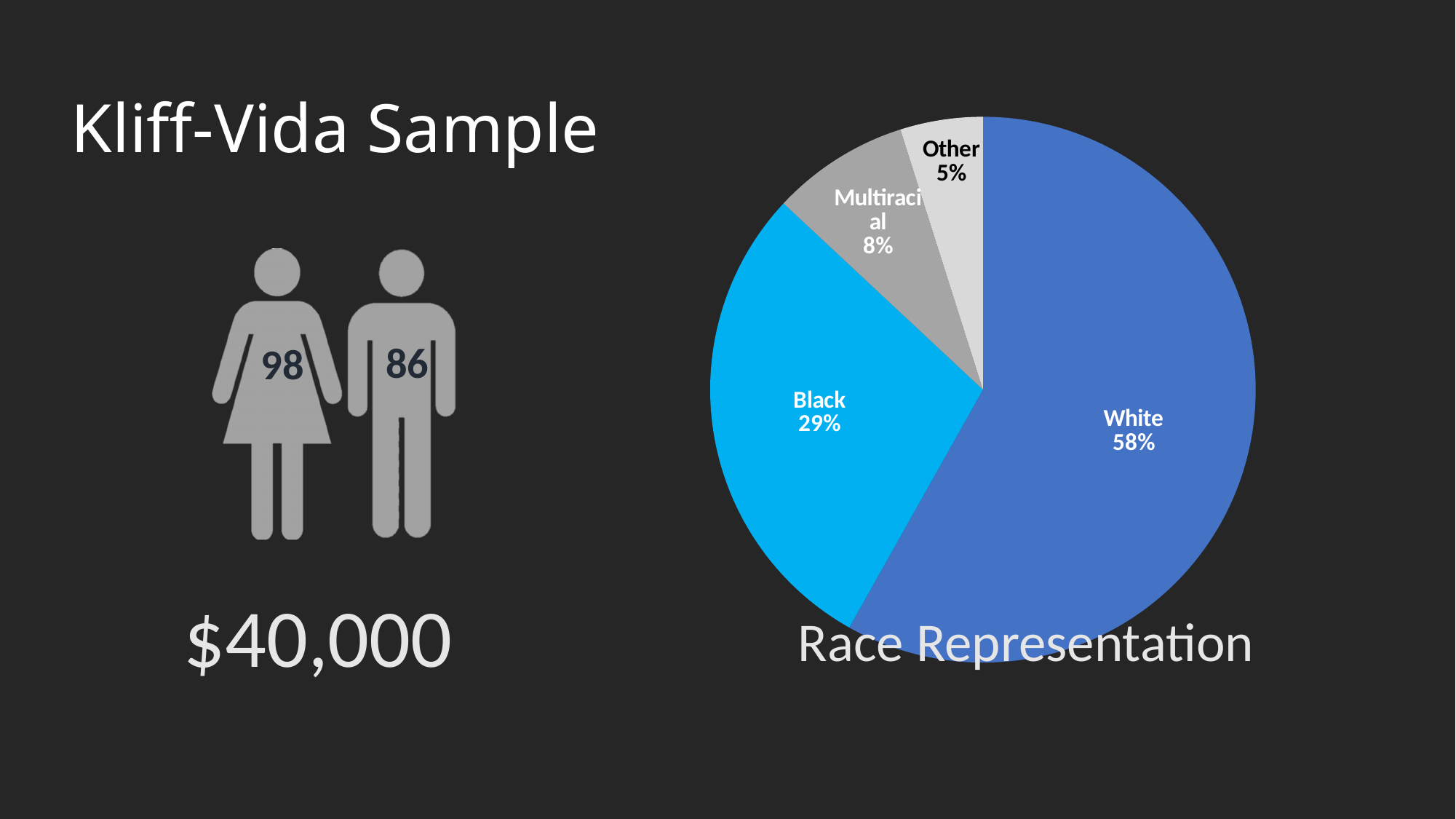
What share of the Race Representation pie chart is Other? 5% What share of the Race Representation pie chart is Multiracial? 8% In the Race Representation pie chart, which is larger, Multiracial or Other? Multiracial In the Race Representation pie chart, what is the difference in percentage points between White and Black? 29 In the Race Representation pie chart, what is the combined share of Black and Multiracial? 37% Which category has the largest slice in the Race Representation pie chart? White What share of the Race Representation pie chart is White? 58% What kind of chart is the Race Representation chart? Pie chart Which category has the smallest slice in the Race Representation pie chart? Other What colour is the Black slice in the Race Representation pie chart? Light blue What share of the Race Representation pie chart is Black? 29% How many slices does the Race Representation pie chart have? 4